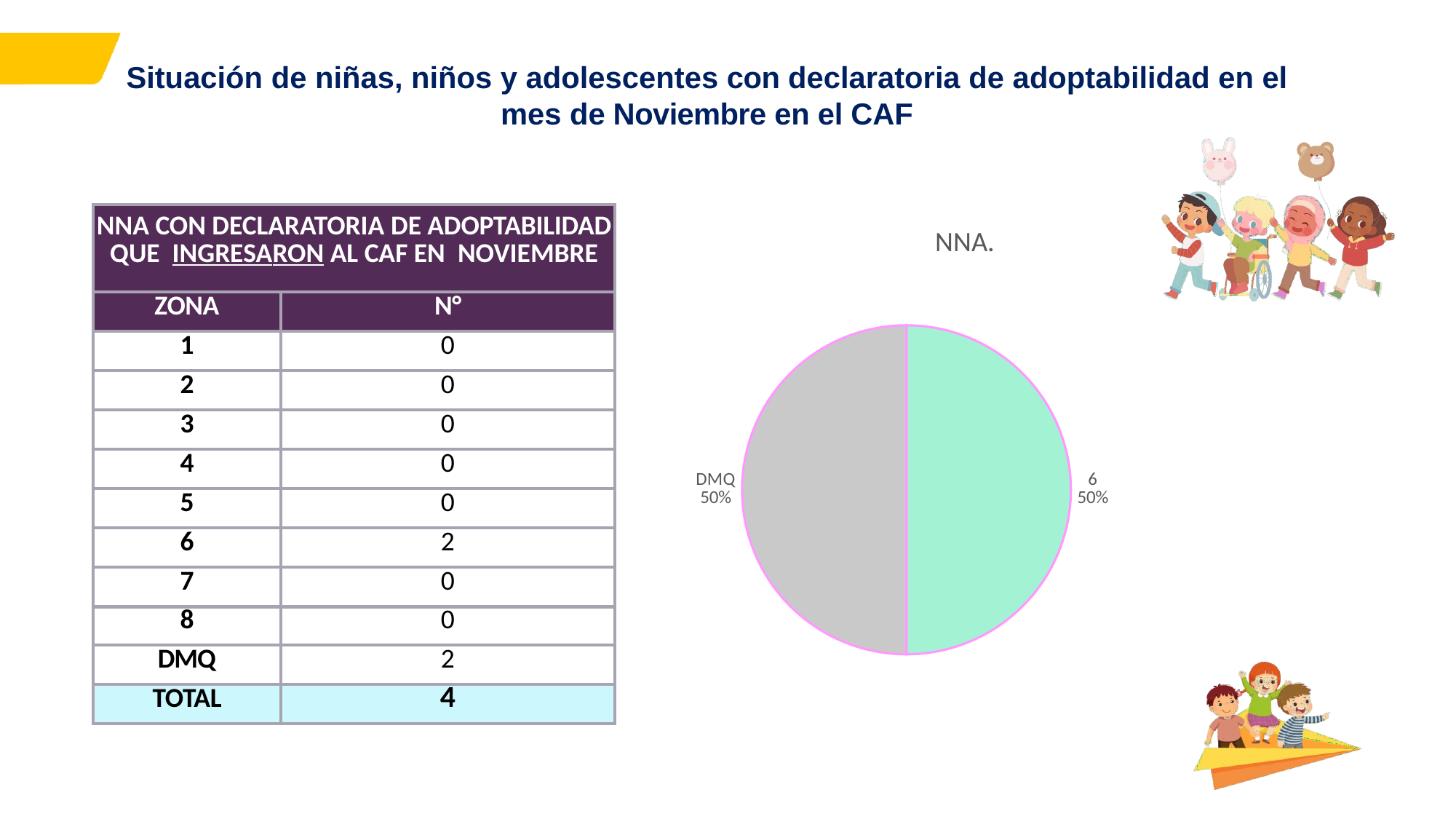
What colour is the DMQ slice in the pie chart? grey What share of the pie chart does the DMQ slice represent? 50% What share of the pie chart does the slice labelled 6 represent? 50% What is the title of the pie chart? NNA. Do the DMQ slice and the slice labelled 6 have the same share of the pie chart? yes How many slices does the pie chart have? 2 Which slices are labelled on the pie chart? DMQ and 6 What kind of chart is shown on the slide? pie chart